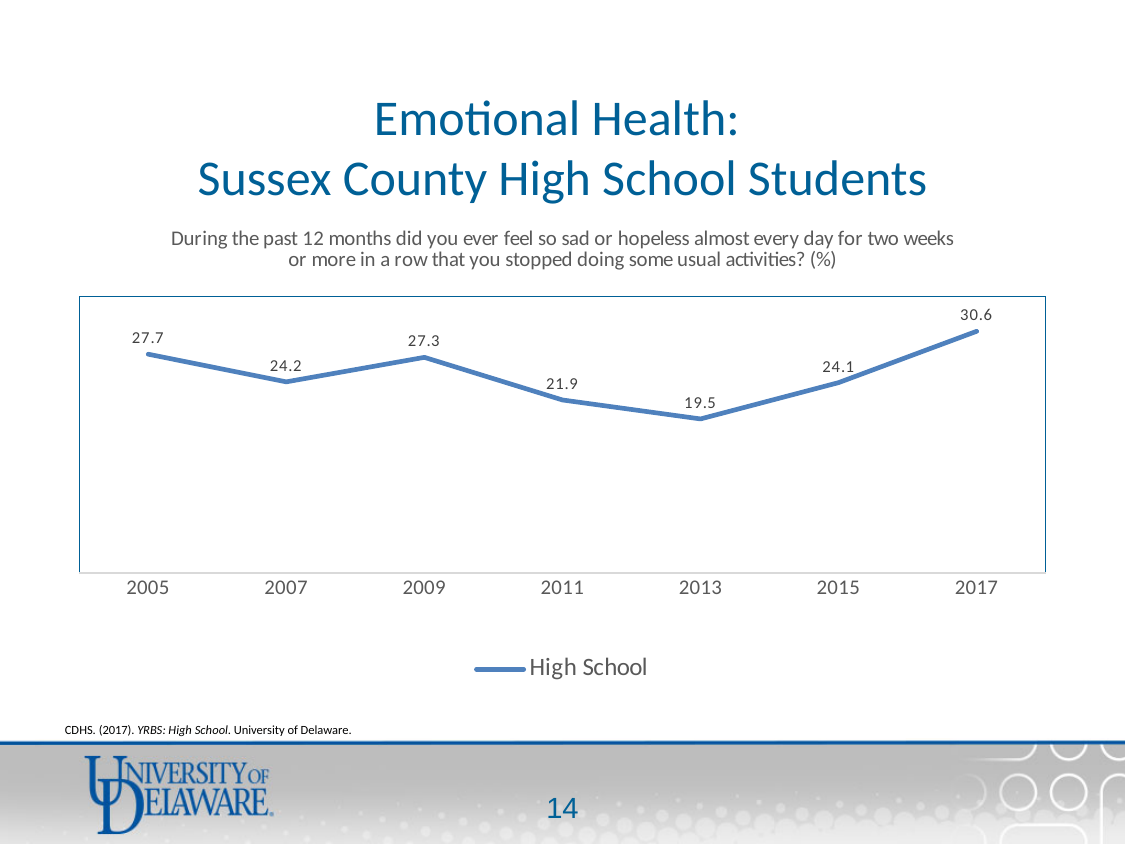
What is the value for 2017? 30.6 Which year has the lowest value? 2013 What is the value for 2011? 21.9 How many series does the legend list? 1 What is the value for 2005? 27.7 What is the name of the series shown in the legend? High School Which is larger, the value for 2009 or the value for 2015? 2009 What is the difference between the values for 2017 and 2013? 11.1 What is the value for 2013? 19.5 Which year has the highest value? 2017 How many years are plotted on the chart? 7 What kind of chart is shown? line chart